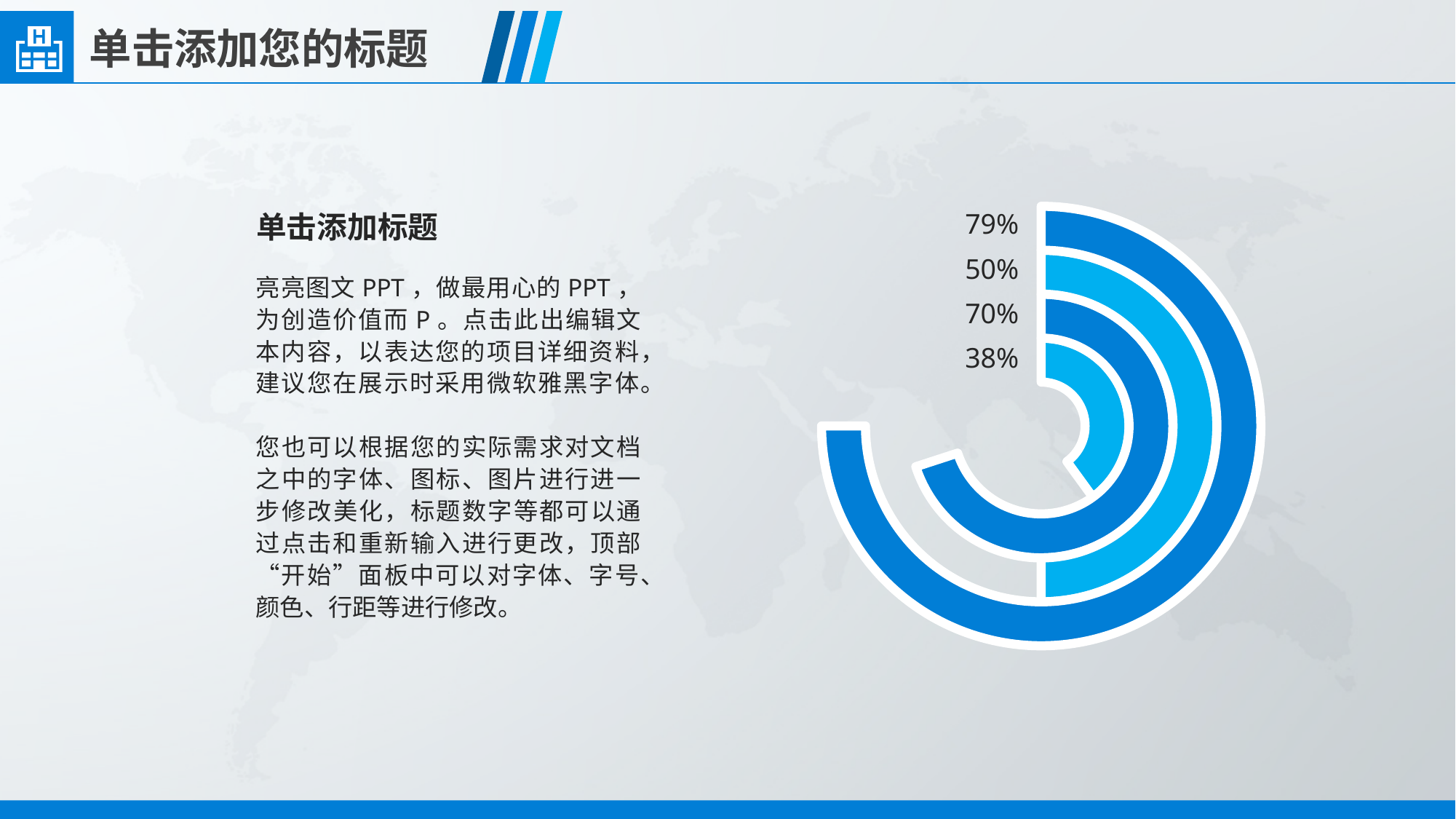
What value is shown for the second ring from the outside? 50% What value is shown for the innermost ring of the chart? 38% What kind of chart is shown on the slide? doughnut chart What is the highest percentage shown on the chart? 79% What is the lowest percentage shown on the chart? 38% Which is larger, the value of the second ring from the outside or the third ring from the outside? the third ring (70%) What value is shown for the outermost ring of the chart? 79% What is the difference between the outermost ring value and the innermost ring value? 41% What is the difference between the 70% ring and the 50% ring? 20% How many different colours are used for the rings in the chart? 2 What value is shown for the third ring from the outside? 70% How many rings (data values) does the chart show? 4